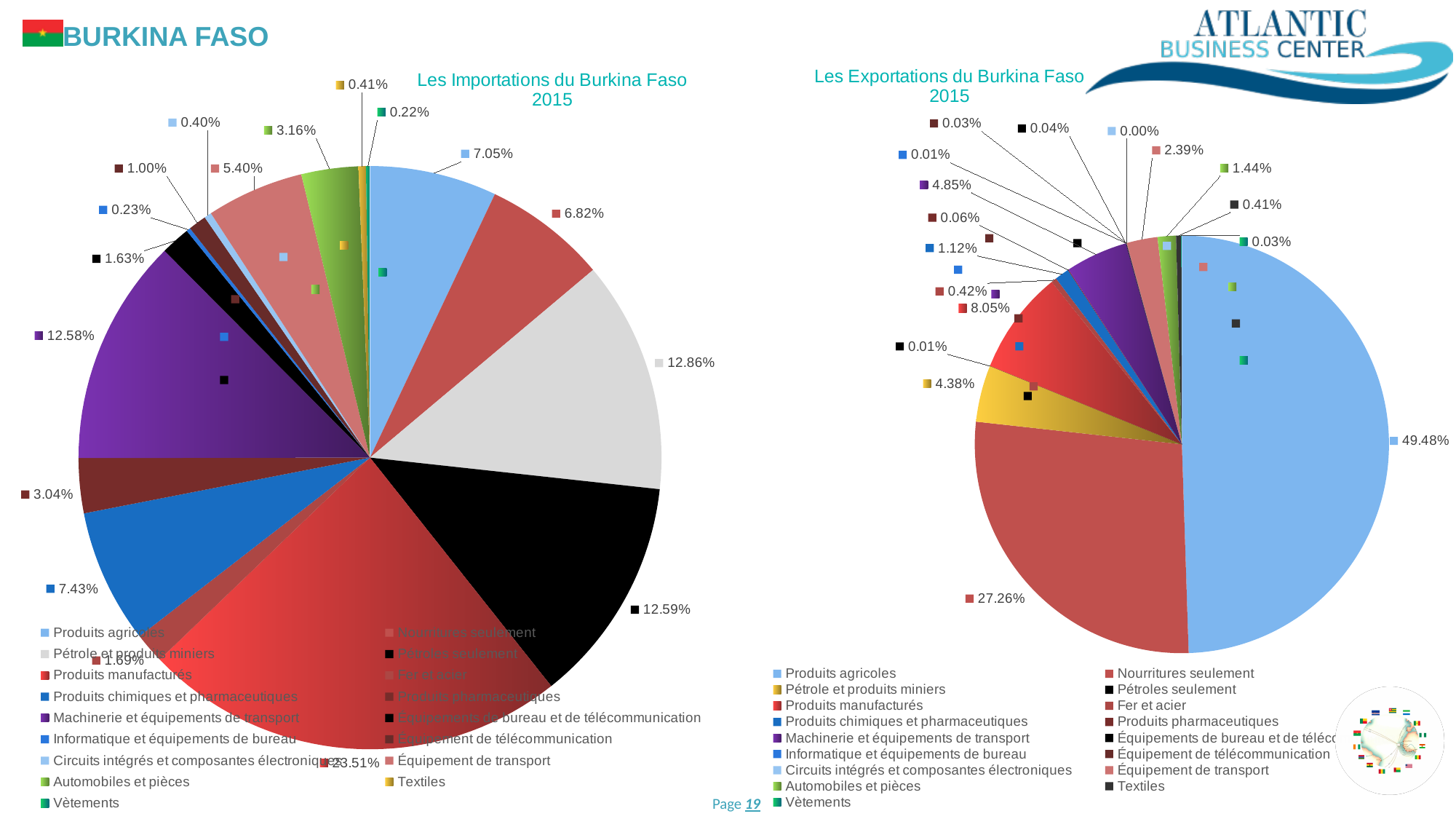
How many categories does the legend of 'Les Exportations du Burkina Faso 2015' list? 17 In 'Les Importations du Burkina Faso 2015', which category has the largest slice? Produits manufacturés In 'Les Exportations du Burkina Faso 2015', what is the share for Produits manufacturés? 8.05% In 'Les Importations du Burkina Faso 2015', what is the share for Pétrole et produits miniers? 12.86% In 'Les Importations du Burkina Faso 2015', what is the difference between the shares of Produits manufacturés and Pétrole et produits miniers? 10.65% In 'Les Importations du Burkina Faso 2015', what is the share for Produits chimiques et pharmaceutiques? 7.43% In 'Les Exportations du Burkina Faso 2015', what is the share for Nourritures seulement? 27.26% What kind of chart is 'Les Importations du Burkina Faso 2015'? Pie chart In 'Les Exportations du Burkina Faso 2015', what is the difference between the shares of Produits agricoles and Nourritures seulement? 22.22% In 'Les Importations du Burkina Faso 2015', which is larger: Produits agricoles or Nourritures seulement? Produits agricoles In 'Les Exportations du Burkina Faso 2015', what is the share for Pétrole et produits miniers? 4.38% In 'Les Exportations du Burkina Faso 2015', which category has the largest slice? Produits agricoles